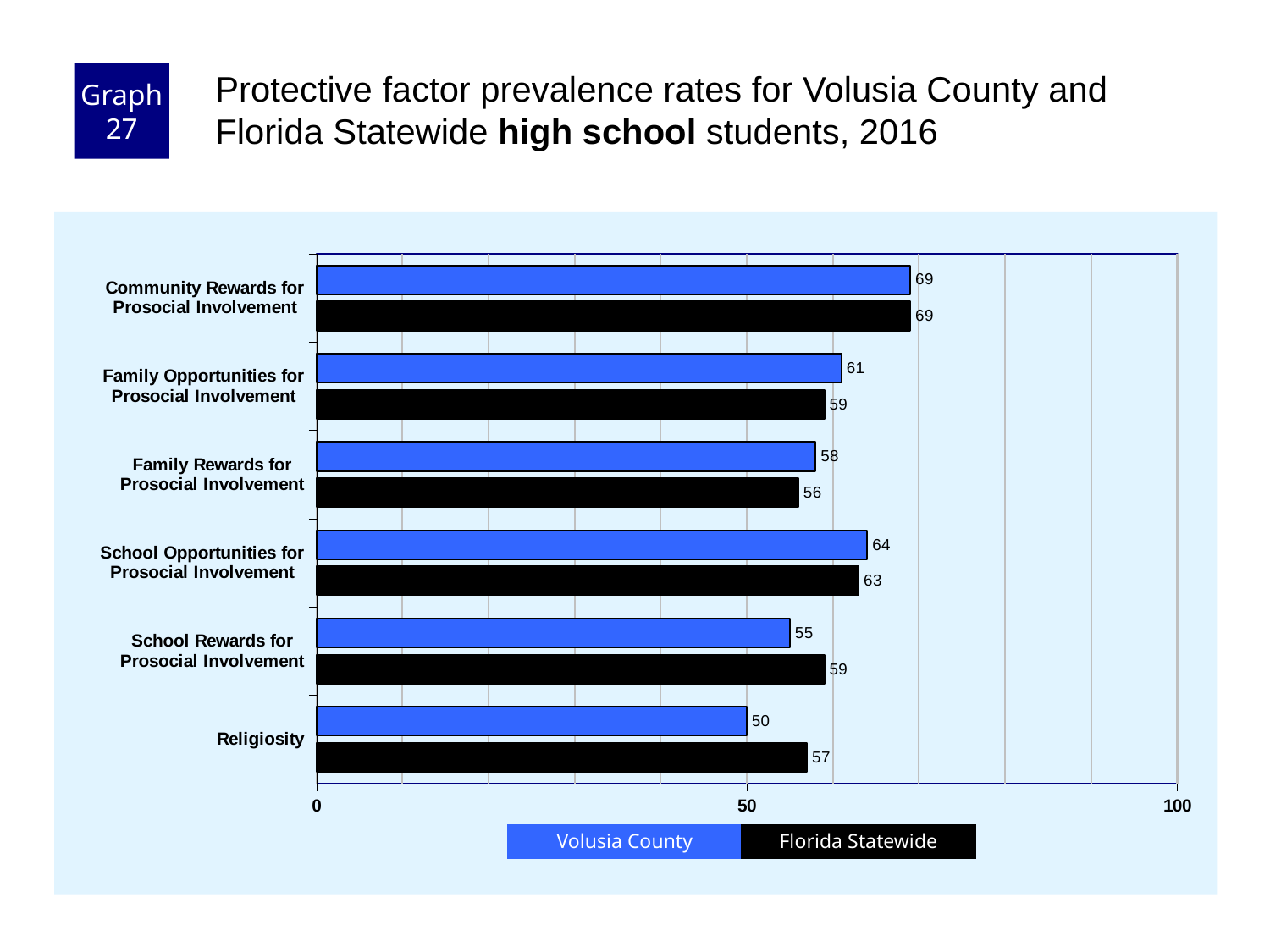
What is the difference between the Florida Statewide and Volusia County values for Religiosity? 7 What kind of chart is shown on the slide? Bar chart How many categories are shown on the chart? 6 Which colour represents Florida Statewide in the chart? Black How many series does the legend list? 2 Which category has the highest Volusia County value? Community Rewards for Prosocial Involvement What is the Volusia County value for School Opportunities for Prosocial Involvement? 64 Which is larger for School Rewards for Prosocial Involvement: Volusia County or Florida Statewide? Florida Statewide What is the Volusia County value for Religiosity? 50 What is the Florida Statewide value for School Rewards for Prosocial Involvement? 59 Which category has the lowest Volusia County value? Religiosity What is the Florida Statewide value for Family Rewards for Prosocial Involvement? 56